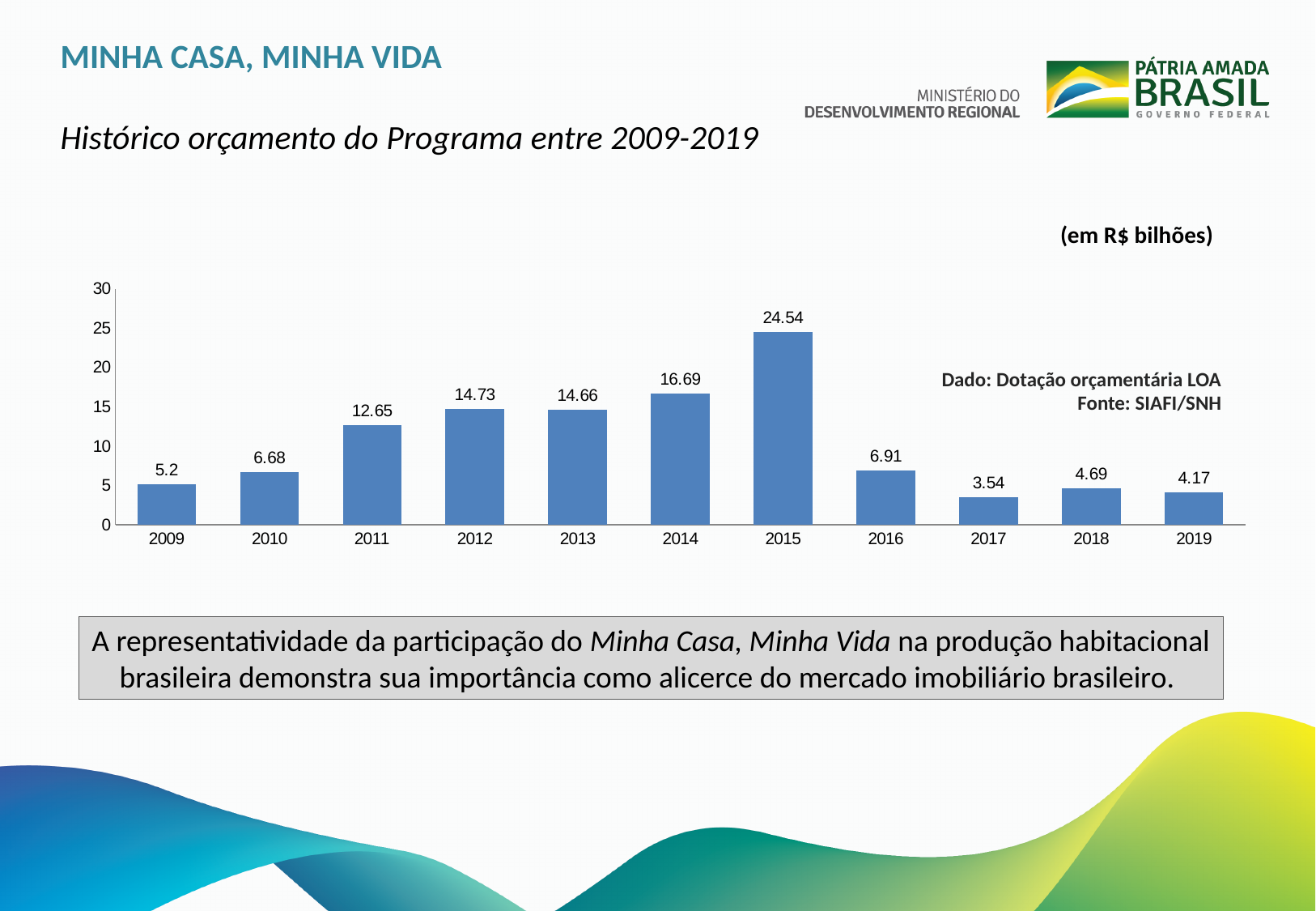
Which year has the highest value? 2015 What is the difference between the values for 2015 and 2016? 17.63 Is the value for 2014 greater or less than 15? greater Do the values rise or fall from 2015 to 2017? fall Which is larger, the value for 2012 or the value for 2013? 2012 How many years are shown on the x axis? 11 What kind of chart is shown on the slide? bar chart What is the value for 2009? 5.2 Which year has the lowest value? 2017 In what unit are the values expressed, according to the label above the chart? R$ bilhões What is the value for 2015? 24.54 What is the value for 2017? 3.54